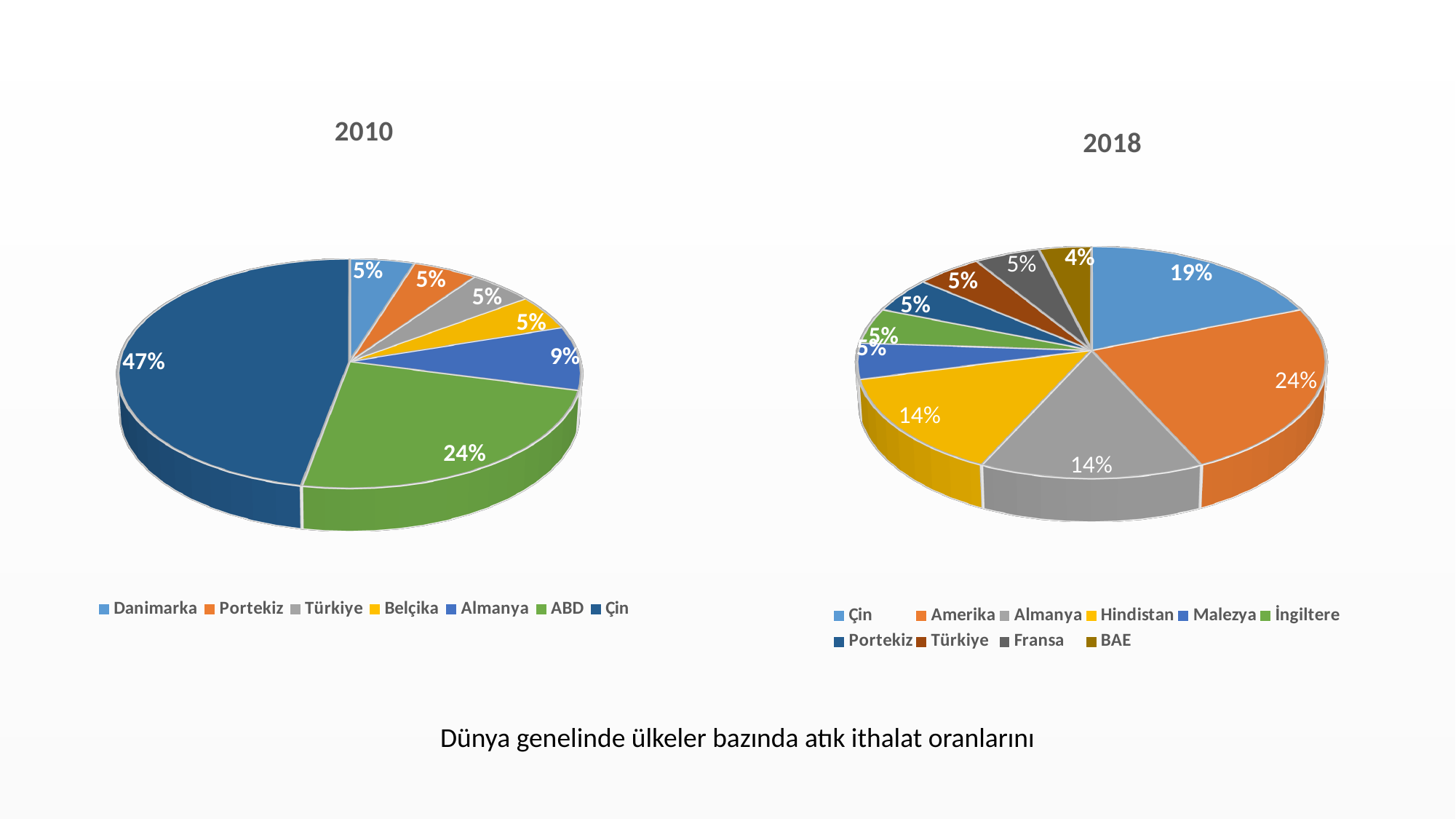
In the 2018 chart, what share does Amerika have? 24% In the 2018 chart, which country has the smallest slice? BAE In the 2018 chart, what share does Çin have? 19% In the 2018 chart, which country has the largest slice? Amerika In the 2018 chart, what share does BAE have? 4% In the 2010 chart, what share does Almanya have? 9% What kind of chart is the 2010 chart? Pie chart In the 2018 chart, how many countries does the legend list? 10 In the 2010 chart, how many countries does the legend list? 7 In the 2010 chart, what share does ABD have? 24% In the 2010 chart, which country has the largest slice? Çin In the 2010 chart, what share does Çin have? 47%